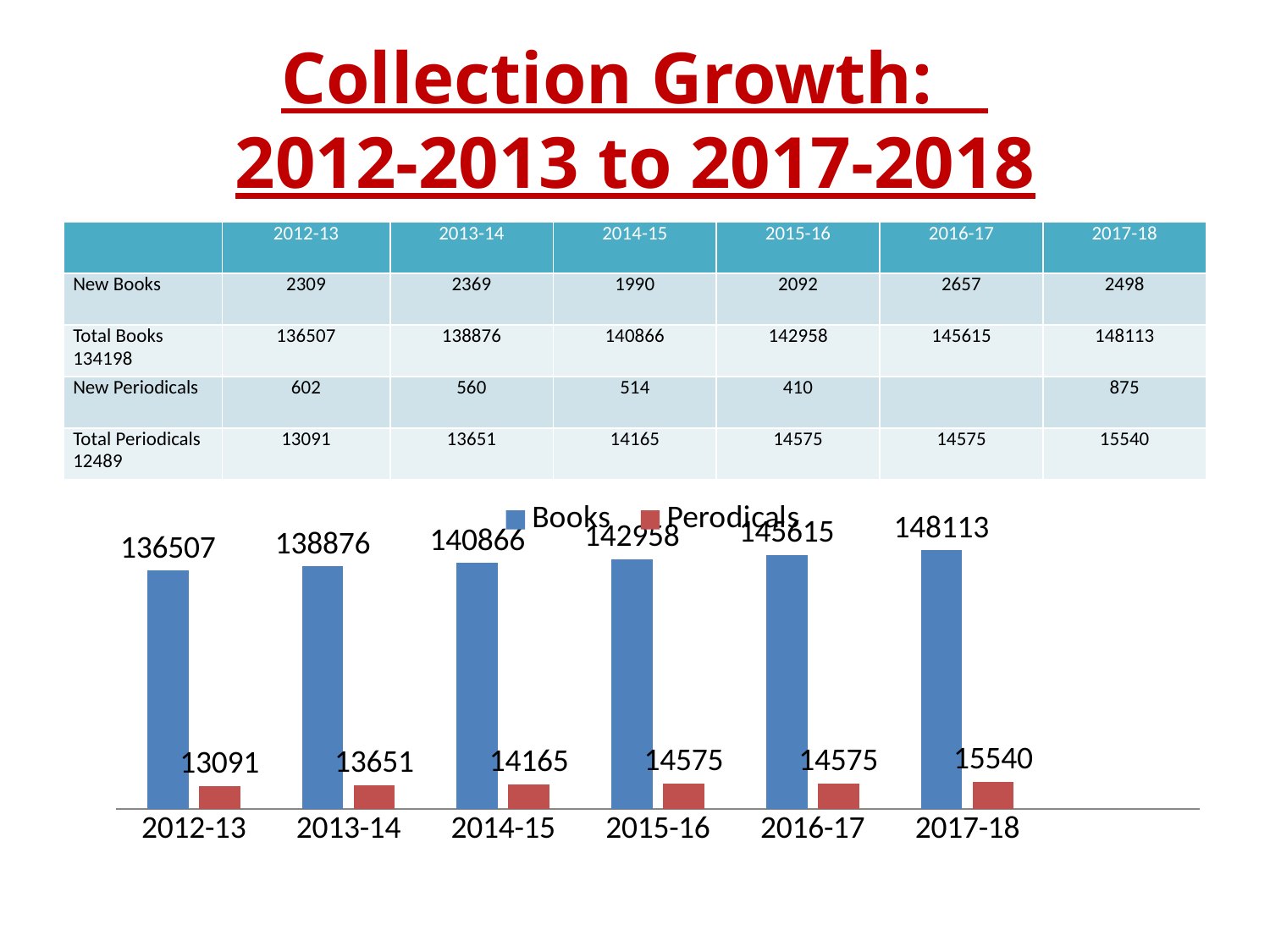
How many years are shown on the x axis of the chart? 6 How many series does the chart legend list? 2 What is the value for Perodicals in 2017-18? 15540 Which year has the lowest value for Perodicals? 2012-13 Which year has the highest value for Books? 2017-18 Which is larger: Perodicals in 2014-15 or Perodicals in 2013-14? 2014-15 What is the value for Books in 2015-16? 142958 What is the value for Books in 2012-13? 136507 What kind of chart is shown on the slide? bar chart What is the difference between the Books values for 2017-18 and 2012-13? 11606 Do the Books values rise or fall from 2012-13 to 2017-18? rise What colour are the Books bars in the chart? blue